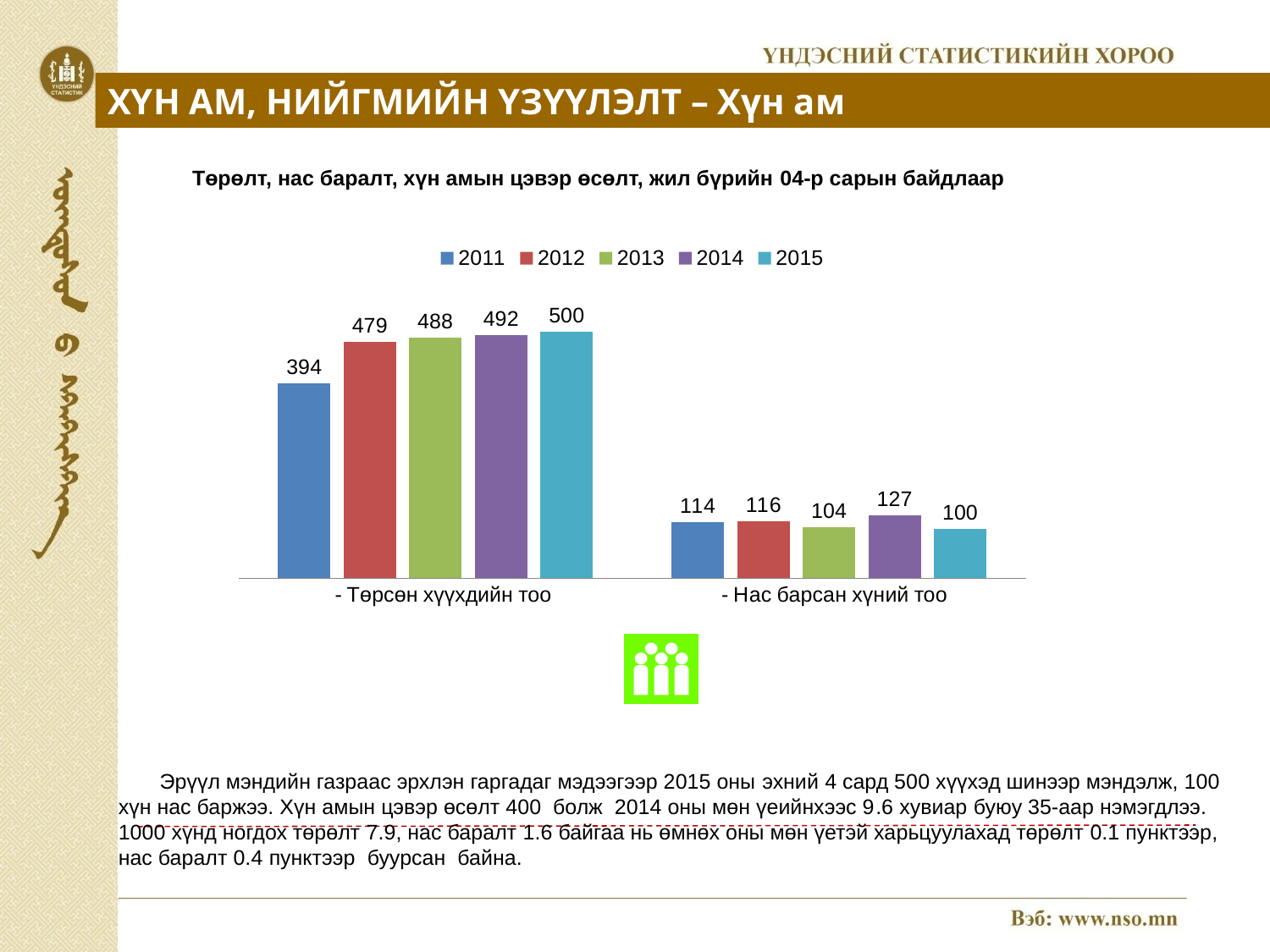
How many series does the legend list? 5 What is the difference between the 2015 and 2011 values in the category '- Төрсөн хүүхдийн тоо'? 106 What type of chart is shown on the slide? bar chart What is the value for 2011 in the category '- Нас барсан хүний тоо'? 114 How many categories are shown on the x axis? 2 What is the title of the chart? Төрөлт, нас баралт, хүн амын цэвэр өсөлт, жил бүрийн 04-р сарын байдлаар Do the values for '- Төрсөн хүүхдийн тоо' rise or fall from 2011 to 2015? rise Which is larger in the category '- Нас барсан хүний тоо': the value for 2013 or the value for 2014? 2014 What is the value for 2015 in the category '- Төрсөн хүүхдийн тоо'? 500 What is the value for 2014 in the category '- Нас барсан хүний тоо'? 127 Which year has the lowest value in the category '- Нас барсан хүний тоо'? 2015 Which year has the highest value in the category '- Төрсөн хүүхдийн тоо'? 2015